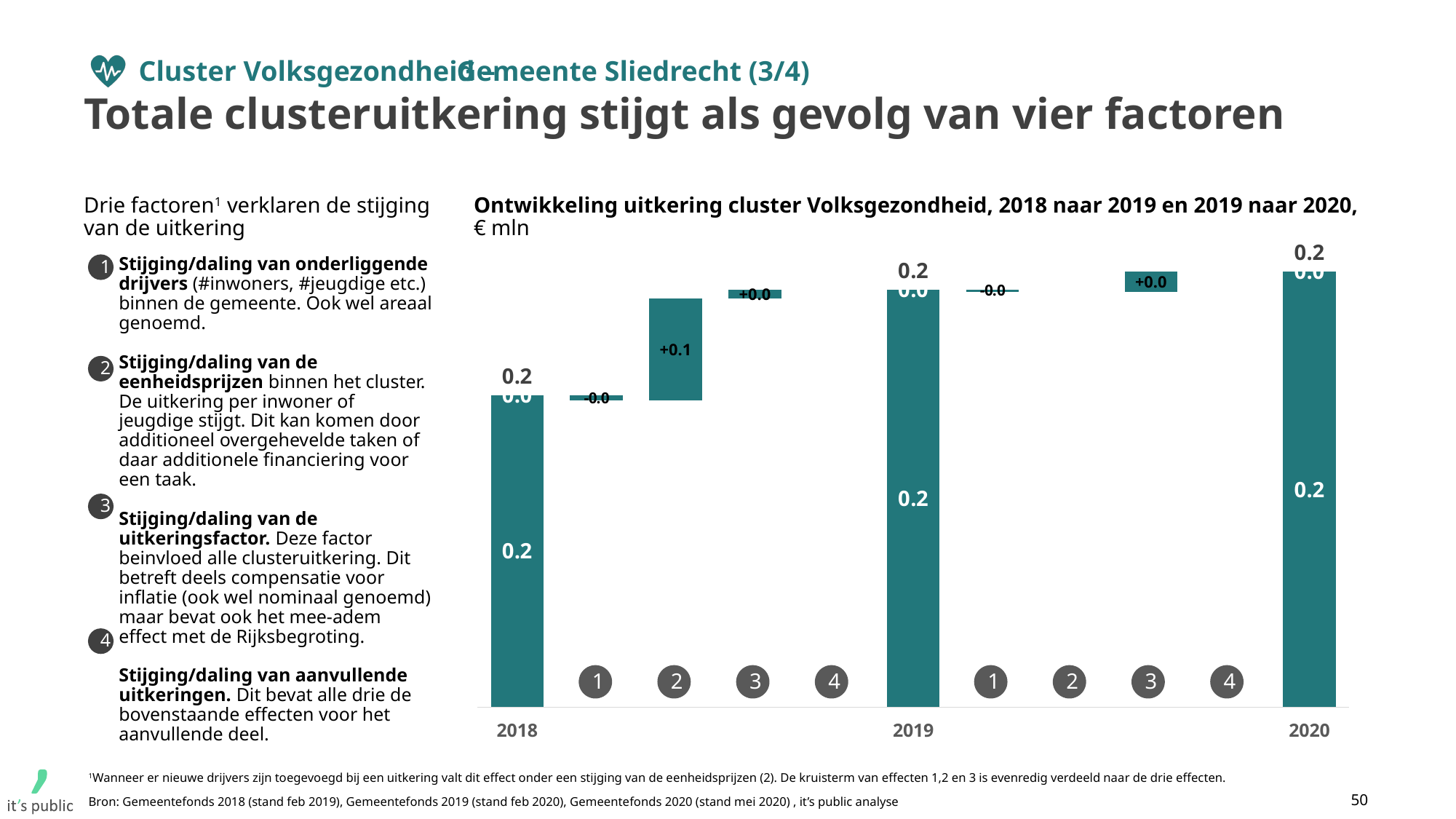
What is the value of the effect of factor 2 in the step from 2018 to 2019? +0.1 What is the total value of the bar for 2018? 0.2 What kind of chart is shown on the slide? bar chart What is the value of the effect of factor 1 in the step from 2018 to 2019? -0.0 What is the title of the chart? Ontwikkeling uitkering cluster Volksgezondheid, 2018 naar 2019 en 2019 naar 2020, € mln What is the value of the effect of factor 3 in the step from 2018 to 2019? +0.0 Which factor has the largest effect in the step from 2018 to 2019? 2 In what unit are the values in the chart expressed? € mln What is the total value of the bar for 2020? 0.2 How many years have a total bar in the chart? 3